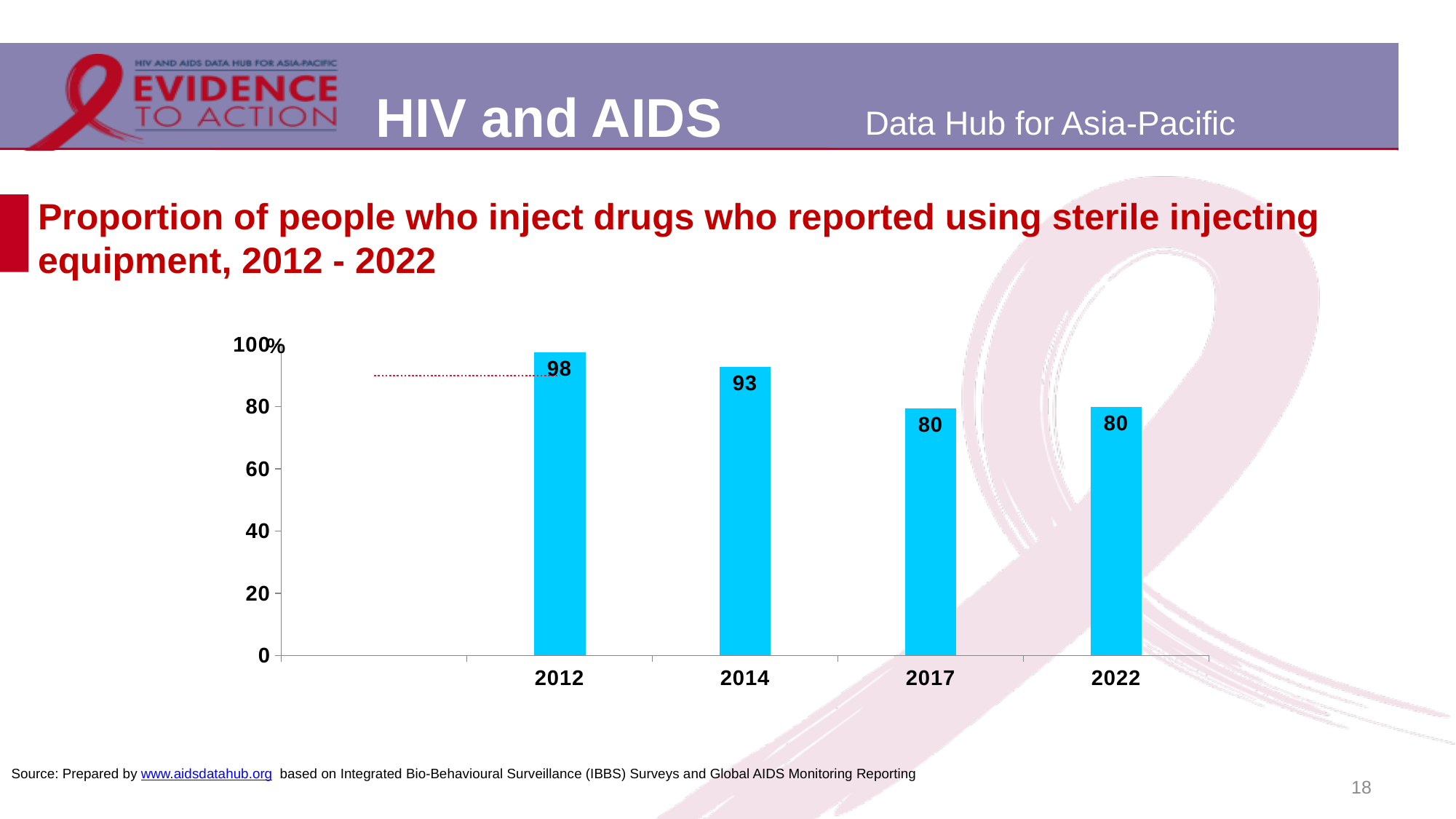
What is the value for 2014? 93 How many years are shown on the x axis? 4 Which year has the highest value? 2012 What is the value for 2017? 80 Is the value for 2017 greater or less than 60? greater What is the value for 2012? 98 What is the difference between the values for 2012 and 2014? 5 What is the difference between the values for 2012 and 2022? 18 Do the values rise or fall from 2012 to 2017? Fall What is the value for 2022? 80 What kind of chart is shown on the slide? Bar chart Which is larger, the value for 2014 or the value for 2017? 2014